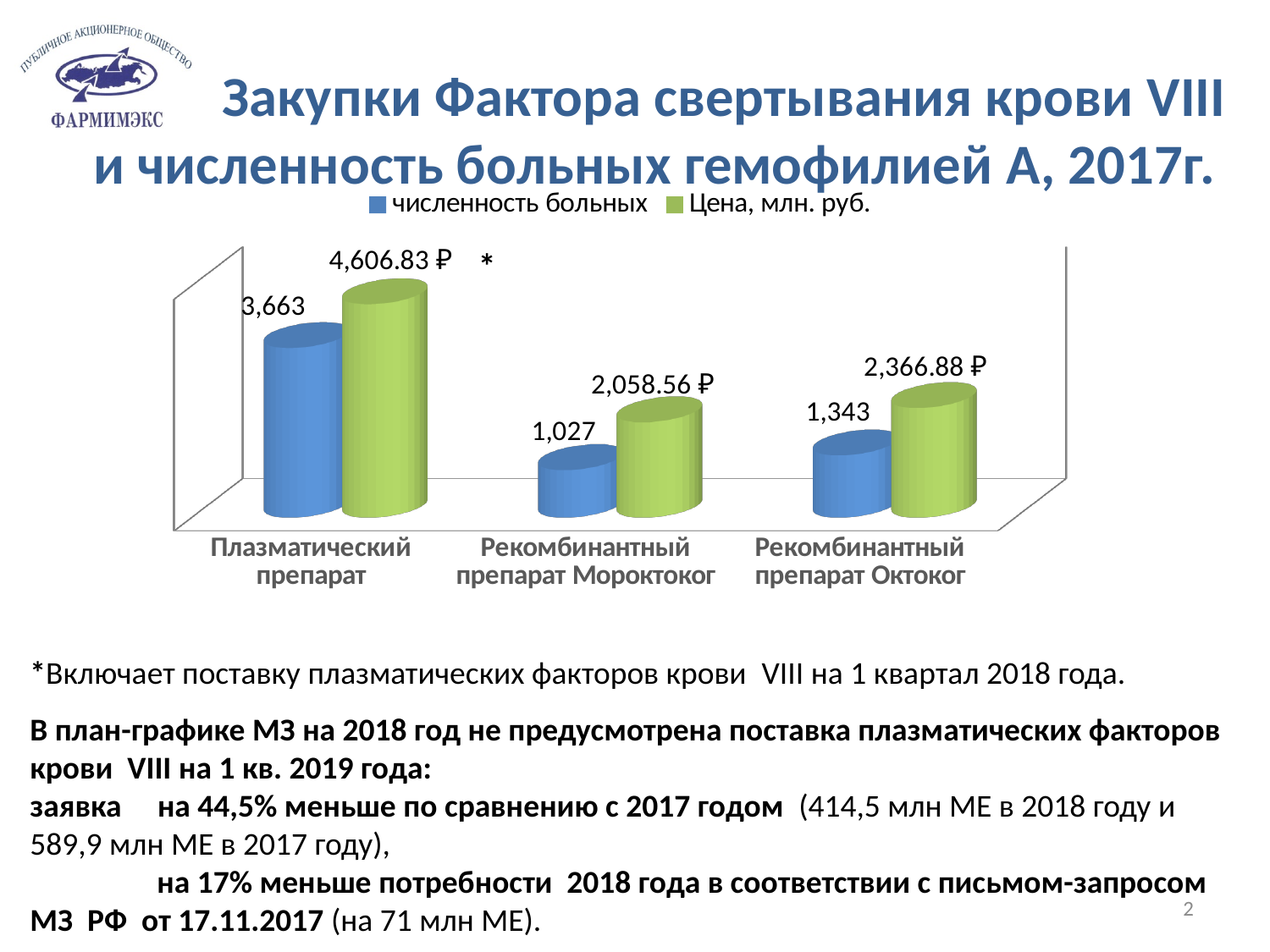
How many series does the chart legend list? 2 Which is larger: численность больных for Рекомбинантный препарат Октоког or for Рекомбинантный препарат Мороктоког? Рекомбинантный препарат Октоког What is the difference in Цена, млн. руб. between Рекомбинантный препарат Октоког and Рекомбинантный препарат Мороктоког? 308.32 ₽ What kind of chart is shown on the slide? Bar chart How many categories are shown on the x axis of the chart? 3 What is the value of Цена, млн. руб. for Рекомбинантный препарат Октоког? 2,366.88 ₽ What is the value of численность больных for Рекомбинантный препарат Октоког? 1,343 What is the value of Цена, млн. руб. for Рекомбинантный препарат Мороктоког? 2,058.56 ₽ What is the value of численность больных for Плазматический препарат? 3,663 Which category has the highest value for Цена, млн. руб.? Плазматический препарат What is the difference in численность больных between Плазматический препарат and Рекомбинантный препарат Октоког? 2,320 Which category has the lowest value for численность больных? Рекомбинантный препарат Мороктоког